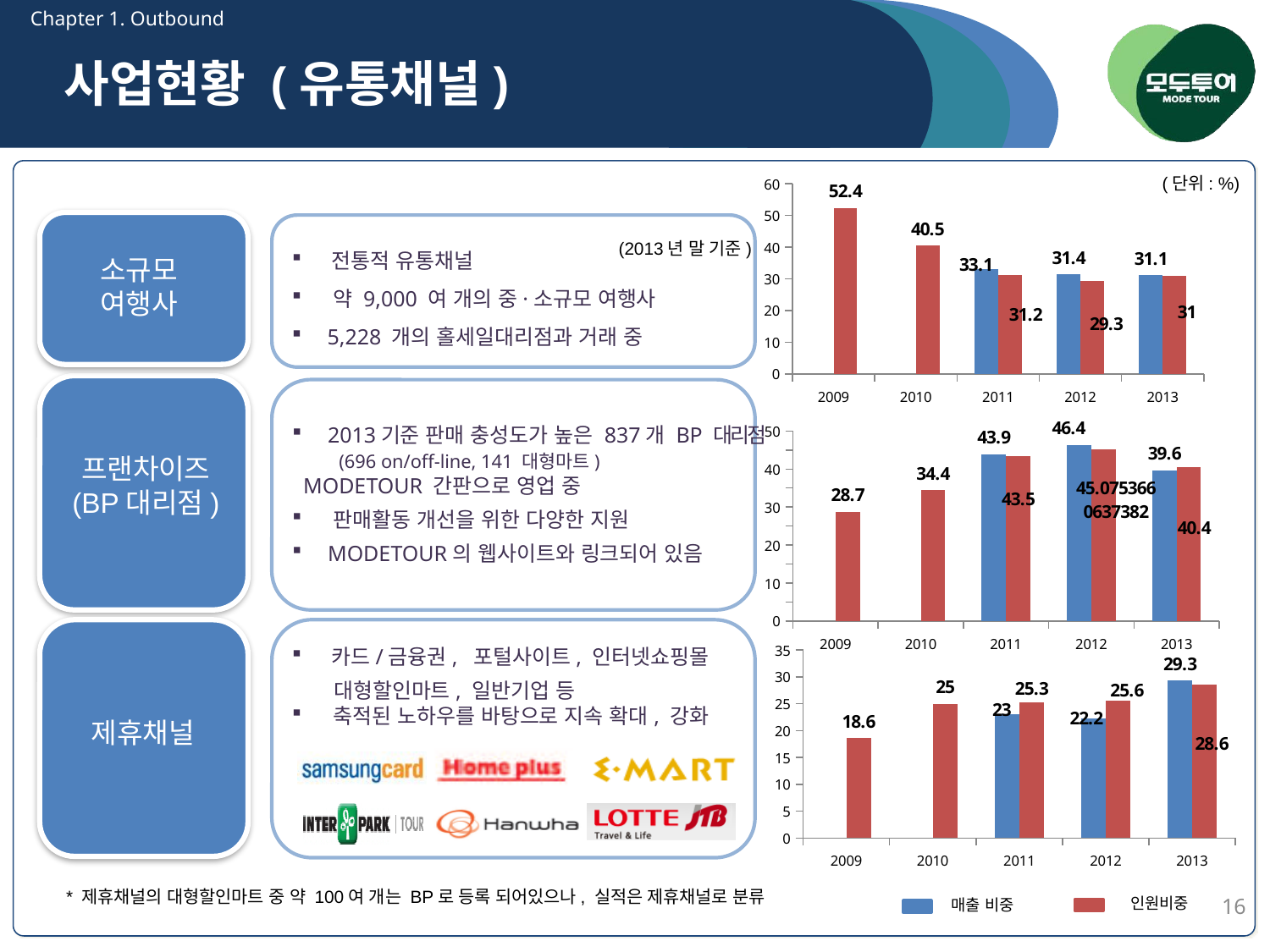
In the top chart on the right, what is the 인원비중 value for 2009? 52.4 In the top chart on the right, what is the difference between the 인원비중 values for 2009 and 2010? 11.9 In the middle chart on the right, which year has the lowest 인원비중 value? 2009 In the middle chart on the right, what is the 매출 비중 value for 2012? 46.4 In the bottom chart on the right, which is larger for 2013, 매출 비중 or 인원비중? 매출 비중 In the top chart on the right, which year has the highest 인원비중 value? 2009 In the bottom chart on the right, what is the difference between the 매출 비중 values for 2013 and 2011? 6.3 In the bottom chart on the right, what is the 인원비중 value for 2012? 25.6 How many series does the legend at the bottom right of the slide list? 2 What type of chart is the bottom chart on the right? Bar chart In the top chart on the right, what is the 매출 비중 value for 2011? 33.1 In the middle chart on the right, is the 매출 비중 value for 2013 greater or less than 40? less